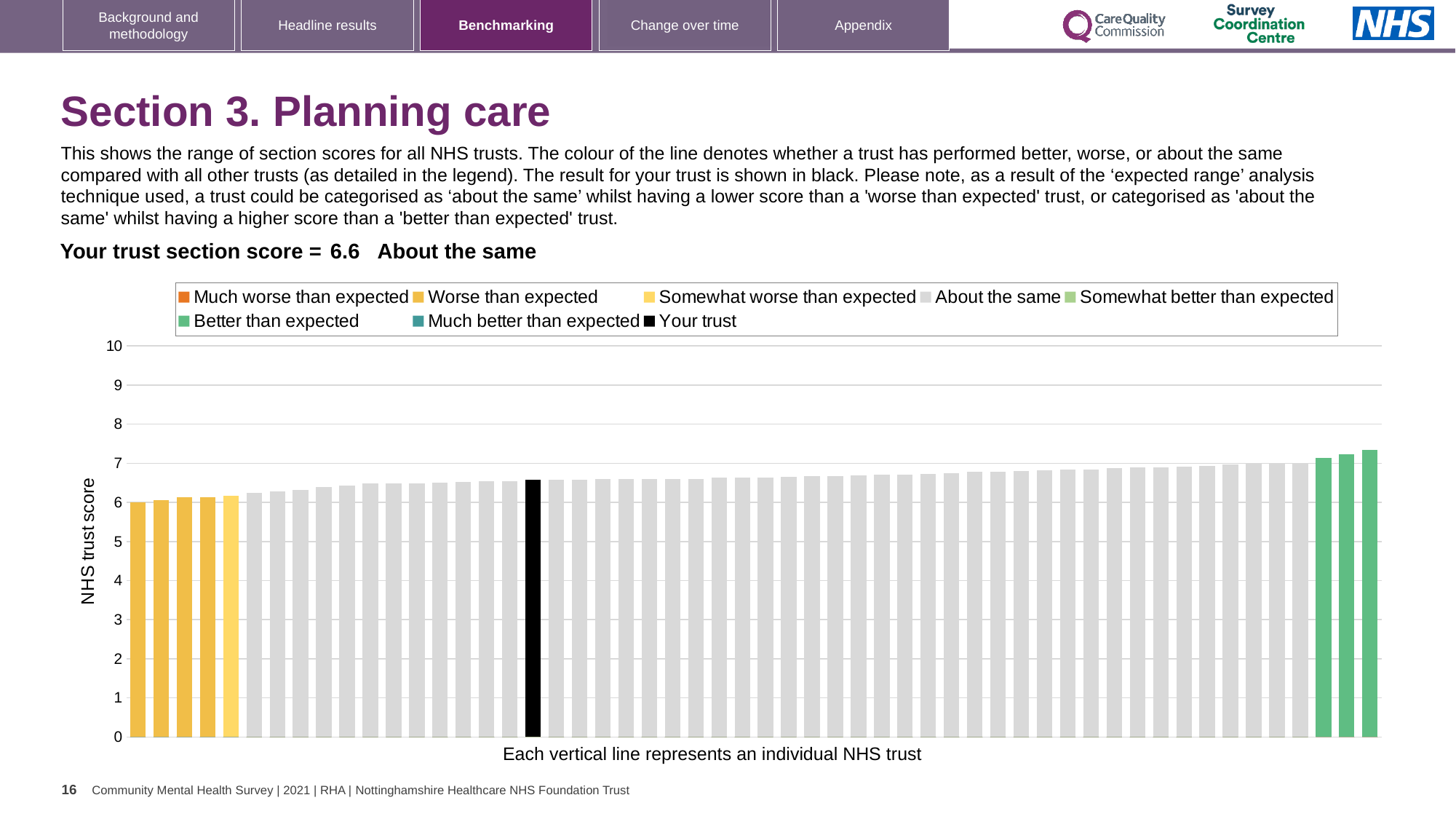
How many bars are coloured as 'Worse than expected' (dark yellow)? 4 How many entries does the chart legend list? 8 How many bars are coloured as 'Better than expected' (green)? 3 What is the trust section score shown on the slide? 6.6 Which performance category is the trust's section score labelled as? About the same What kind of chart is shown on the slide? bar chart Is the black 'Your trust' bar higher or lower than the rightmost green bar? lower Is the value of the tallest bar in the chart greater or less than 8? less What is the label on the vertical axis of the chart? NHS trust score Do the bar values rise or fall from left to right along the x axis? rise Is the value of the black 'Your trust' bar greater or less than 6? greater Is the value of the leftmost (lowest) bar greater or less than 5? greater